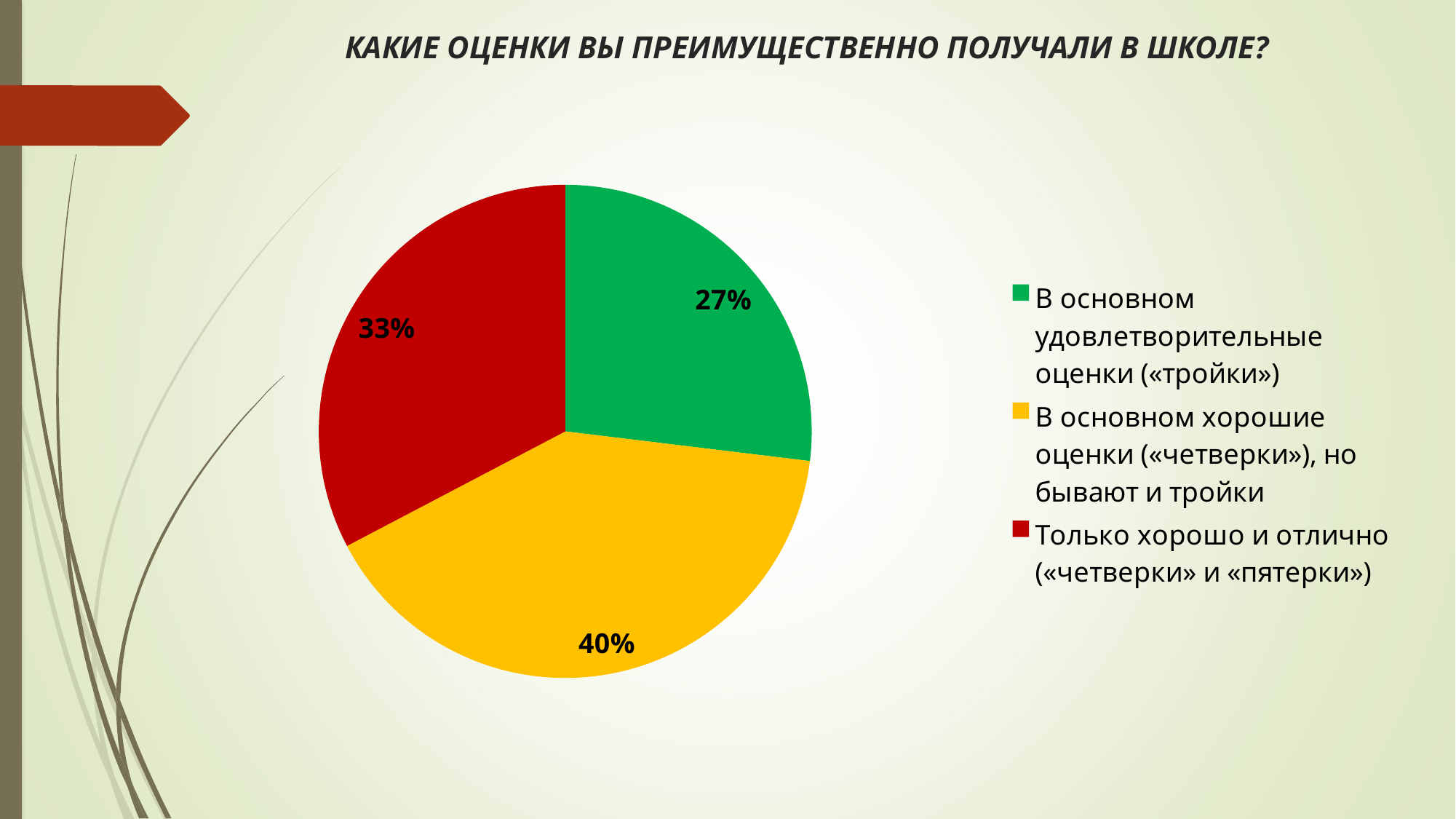
What percentage is shown for «Только хорошо и отлично («четверки» и «пятерки»)»? 33% What percentage is shown for «В основном хорошие оценки («четверки»), но бывают и тройки»? 40% What type of chart is shown on the slide? pie chart What is the title of the chart? КАКИЕ ОЦЕНКИ ВЫ ПРЕИМУЩЕСТВЕННО ПОЛУЧАЛИ В ШКОЛЕ? How many slices does the pie chart have? 3 Which is larger: the share for «Только хорошо и отлично («четверки» и «пятерки»)» or the share for «В основном удовлетворительные оценки («тройки»)»? Только хорошо и отлично («четверки» и «пятерки») What is the difference in percentage points between the «Только хорошо и отлично» slice and the «тройки» slice? 6 What is the difference in percentage points between the «четверки, но бывают и тройки» slice and the «тройки» slice? 13 What colour is the slice for «Только хорошо и отлично («четверки» и «пятерки»)»? red Which category has the largest share of the pie? В основном хорошие оценки («четверки»), но бывают и тройки What percentage is shown for «В основном удовлетворительные оценки («тройки»)»? 27% Which category has the smallest share of the pie? В основном удовлетворительные оценки («тройки»)